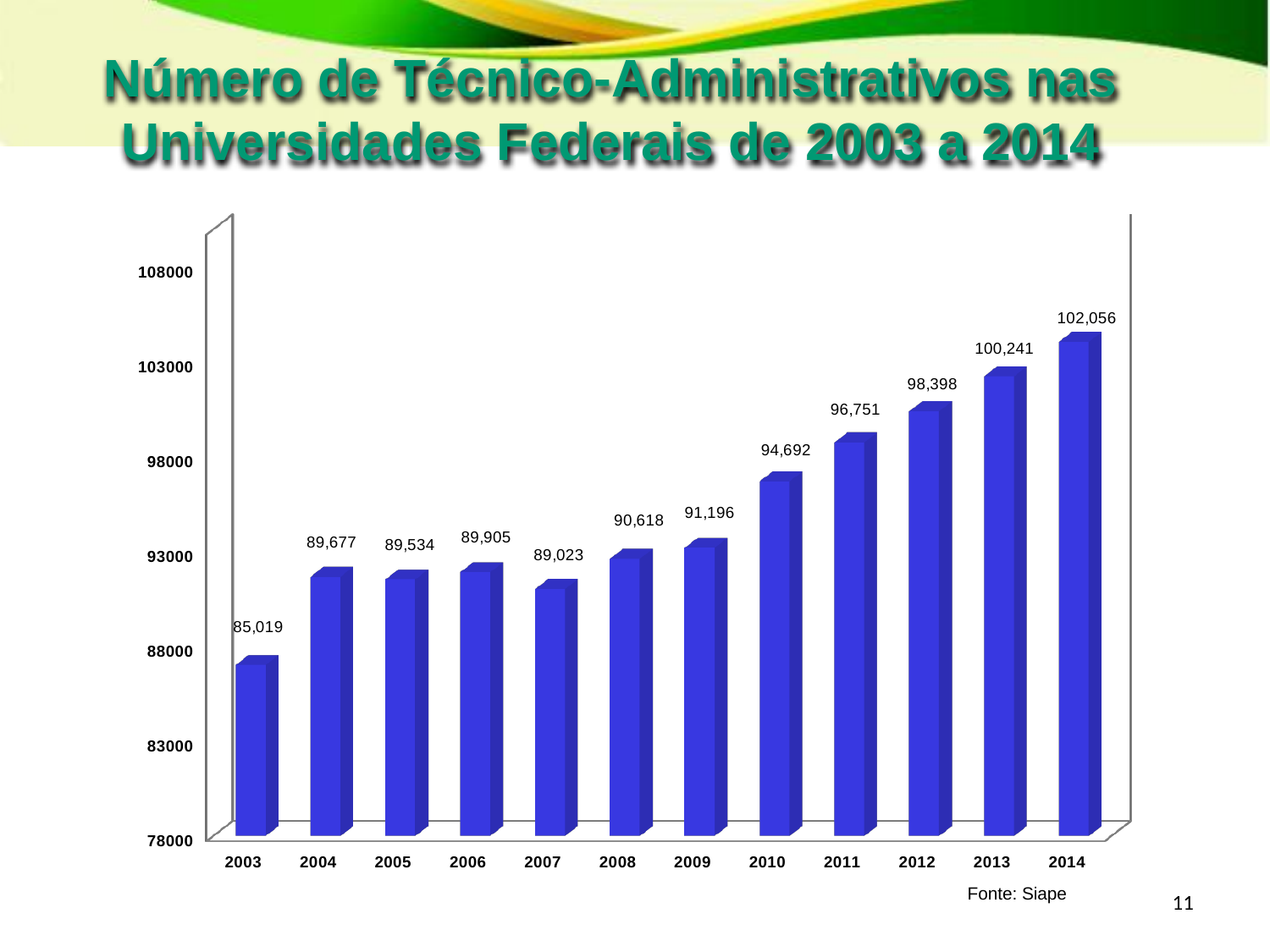
Which year has the lowest value? 2003 What is the value for 2014? 102,056 What value is shown for 2010? 94,692 What kind of chart is shown on the slide? bar chart What is the number of técnico-administrativos in 2003? 85,019 Which year has the highest value? 2014 What is the difference between the values for 2013 and 2012? 1,843 How many years are shown on the x axis? 12 Is the value for 2011 greater or less than 98000? less Which is larger, the value for 2006 or the value for 2007? 2006 What is the difference between the values for 2014 and 2003? 17,037 What source is cited below the chart? Siape